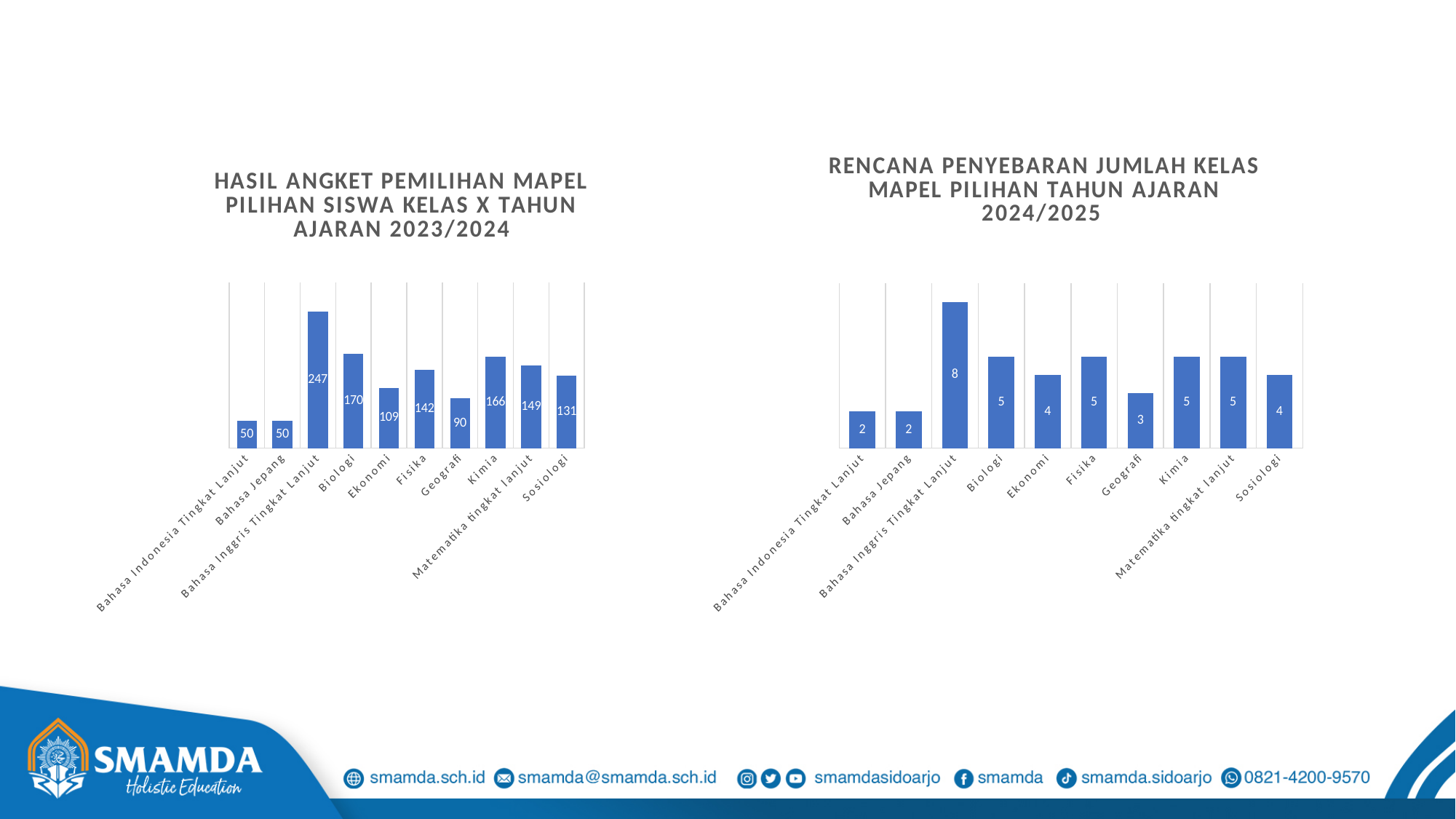
In the right chart (RENCANA PENYEBARAN JUMLAH KELAS MAPEL PILIHAN TAHUN AJARAN 2024/2025), what is the value for Geografi? 3 In the left chart (HASIL ANGKET PEMILIHAN MAPEL PILIHAN SISWA KELAS X TAHUN AJARAN 2023/2024), which is larger, the value for Fisika or the value for Sosiologi? Fisika How many categories are shown in the left chart (HASIL ANGKET PEMILIHAN MAPEL PILIHAN SISWA KELAS X TAHUN AJARAN 2023/2024)? 10 In the left chart (HASIL ANGKET PEMILIHAN MAPEL PILIHAN SISWA KELAS X TAHUN AJARAN 2023/2024), which category has the highest value? Bahasa Inggris Tingkat Lanjut In the left chart (HASIL ANGKET PEMILIHAN MAPEL PILIHAN SISWA KELAS X TAHUN AJARAN 2023/2024), what is the value for Geografi? 90 In the left chart (HASIL ANGKET PEMILIHAN MAPEL PILIHAN SISWA KELAS X TAHUN AJARAN 2023/2024), what is the value for Bahasa Inggris Tingkat Lanjut? 247 In the right chart (RENCANA PENYEBARAN JUMLAH KELAS MAPEL PILIHAN TAHUN AJARAN 2024/2025), what is the value for Bahasa Inggris Tingkat Lanjut? 8 In the left chart (HASIL ANGKET PEMILIHAN MAPEL PILIHAN SISWA KELAS X TAHUN AJARAN 2023/2024), what is the difference between the values for Biologi and Ekonomi? 61 What kind of chart is the right chart (RENCANA PENYEBARAN JUMLAH KELAS MAPEL PILIHAN TAHUN AJARAN 2024/2025)? Bar chart In the left chart (HASIL ANGKET PEMILIHAN MAPEL PILIHAN SISWA KELAS X TAHUN AJARAN 2023/2024), what is the value for Kimia? 166 In the right chart (RENCANA PENYEBARAN JUMLAH KELAS MAPEL PILIHAN TAHUN AJARAN 2024/2025), which category has the highest value? Bahasa Inggris Tingkat Lanjut In the right chart (RENCANA PENYEBARAN JUMLAH KELAS MAPEL PILIHAN TAHUN AJARAN 2024/2025), what is the difference between the values for Biologi and Bahasa Jepang? 3